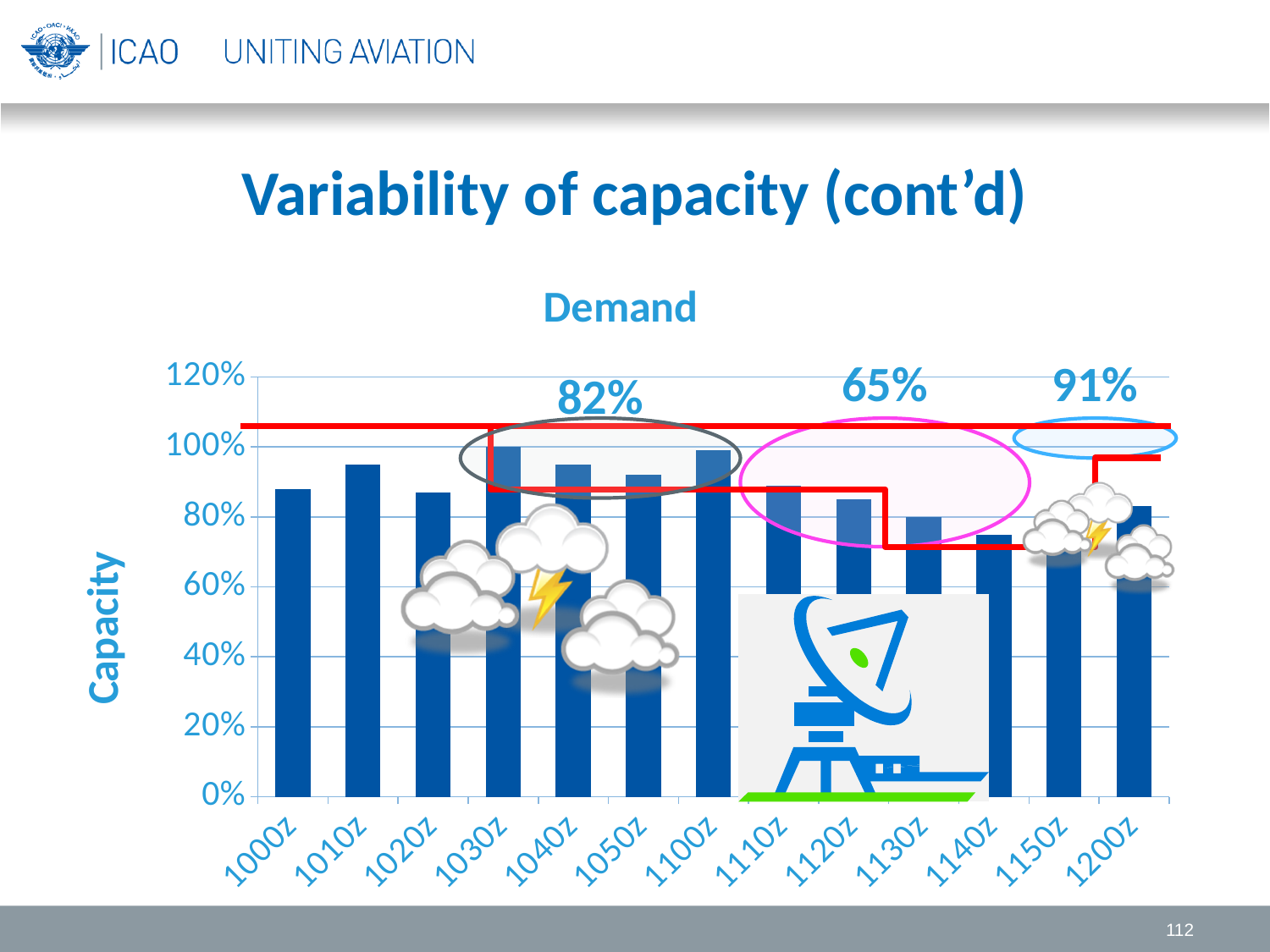
What kind of chart is shown on the slide? bar chart Is the value for 1010Z greater or less than 80%? greater Which has the larger value, 1010Z or 1020Z? 1010Z Which has the larger value, 1030Z or 1140Z? 1030Z Do the bar values rise or fall from 1110Z to 1140Z? fall Is the value for 1120Z greater or less than 60%? greater How many time categories are shown on the x axis of the chart? 13 What is the label on the y axis of the chart? Capacity Is the value for 1140Z greater or less than 80%? less What is the title shown above the chart? Demand